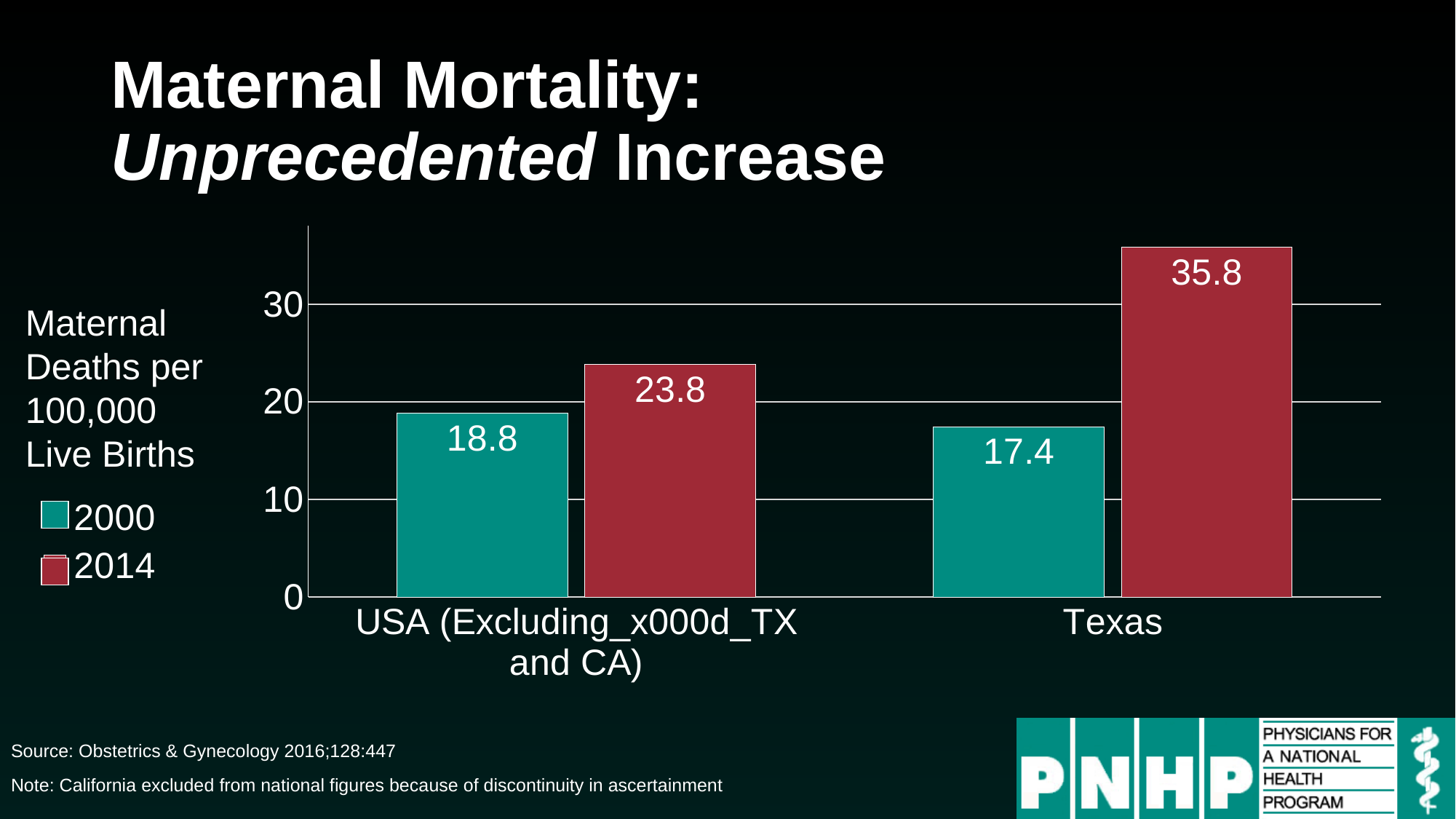
Which bar shows the lowest maternal mortality rate? Texas, 2000 What does the y axis of the chart measure? Maternal Deaths per 100,000 Live Births What was the maternal mortality rate for Texas in 2014? 35.8 What was the maternal mortality rate for USA (Excluding TX and CA) in 2014? 23.8 By how much did the maternal mortality rate in Texas increase from 2000 to 2014? 18.4 Which bar shows the highest maternal mortality rate? Texas, 2014 How many series does the legend list? 2 By how much did the maternal mortality rate for USA (Excluding TX and CA) increase from 2000 to 2014? 5.0 What was the maternal mortality rate for Texas in 2000? 17.4 What type of chart is shown on the slide? Bar chart What was the maternal mortality rate for USA (Excluding TX and CA) in 2000? 18.8 In 2014, which had the higher maternal mortality rate, Texas or USA (Excluding TX and CA)? Texas